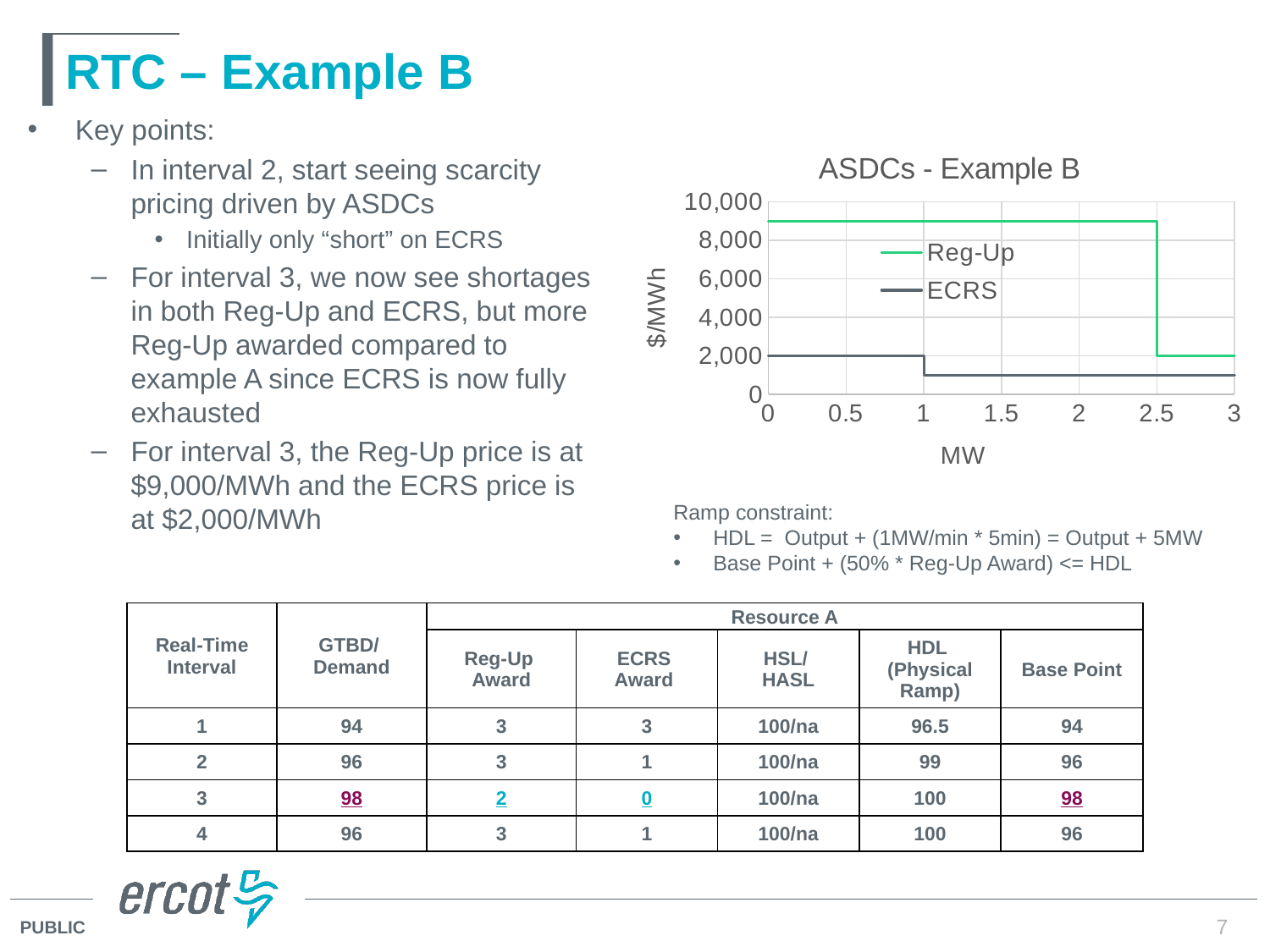
What is the Reg-Up value in $/MWh at 3 MW? 2,000 At what MW value does the Reg-Up line step down? 2.5 How many series does the legend of the chart list? 2 What is the title of the chart? ASDCs - Example B Is the Reg-Up value at 1 MW greater or less than 8,000? greater Is the ECRS value at 2 MW greater or less than 2,000? less What type of chart is shown on the slide? Line chart At 1.5 MW, which series has the higher $/MWh value, Reg-Up or ECRS? Reg-Up At what MW value does the ECRS line step down? 1 Does the Reg-Up line rise or fall as MW increases along the x axis? Fall What is the ECRS value in $/MWh at 0.5 MW? 2,000 What are the two series named in the chart legend? Reg-Up and ECRS